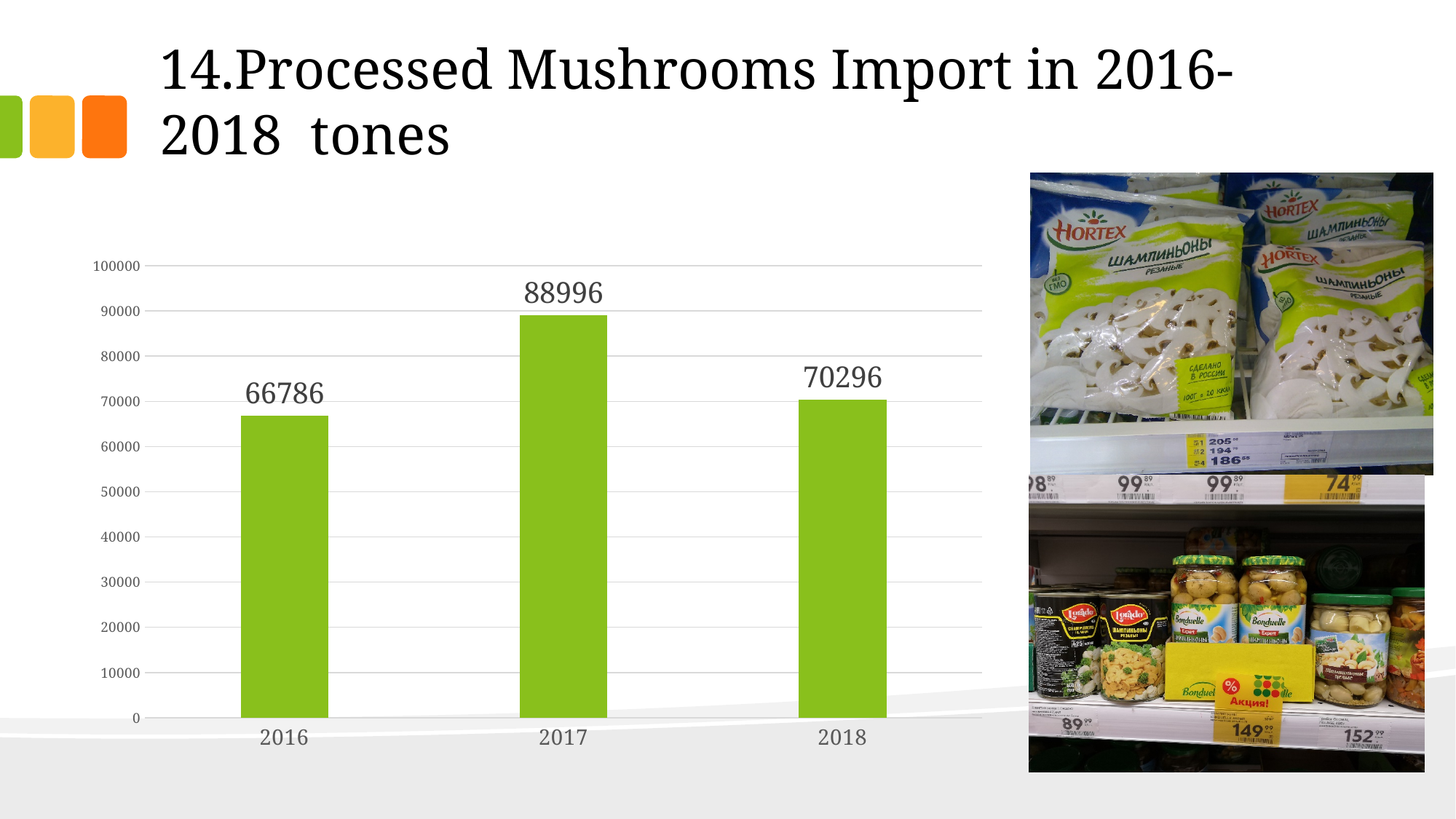
What was the processed mushrooms import in 2016? 66786 What was the processed mushrooms import in 2018? 70296 What kind of chart is shown on the slide? bar chart What is the difference between the import in 2017 and the import in 2016? 22210 What is the difference between the import in 2017 and the import in 2018? 18700 Is the value for 2017 greater or less than 80000? greater How many years are shown on the chart? 3 Which year had the lowest processed mushrooms import? 2016 What was the processed mushrooms import in 2017? 88996 What colour are the bars in the chart? green Which year had a larger import, 2016 or 2018? 2018 Which year had the highest processed mushrooms import? 2017